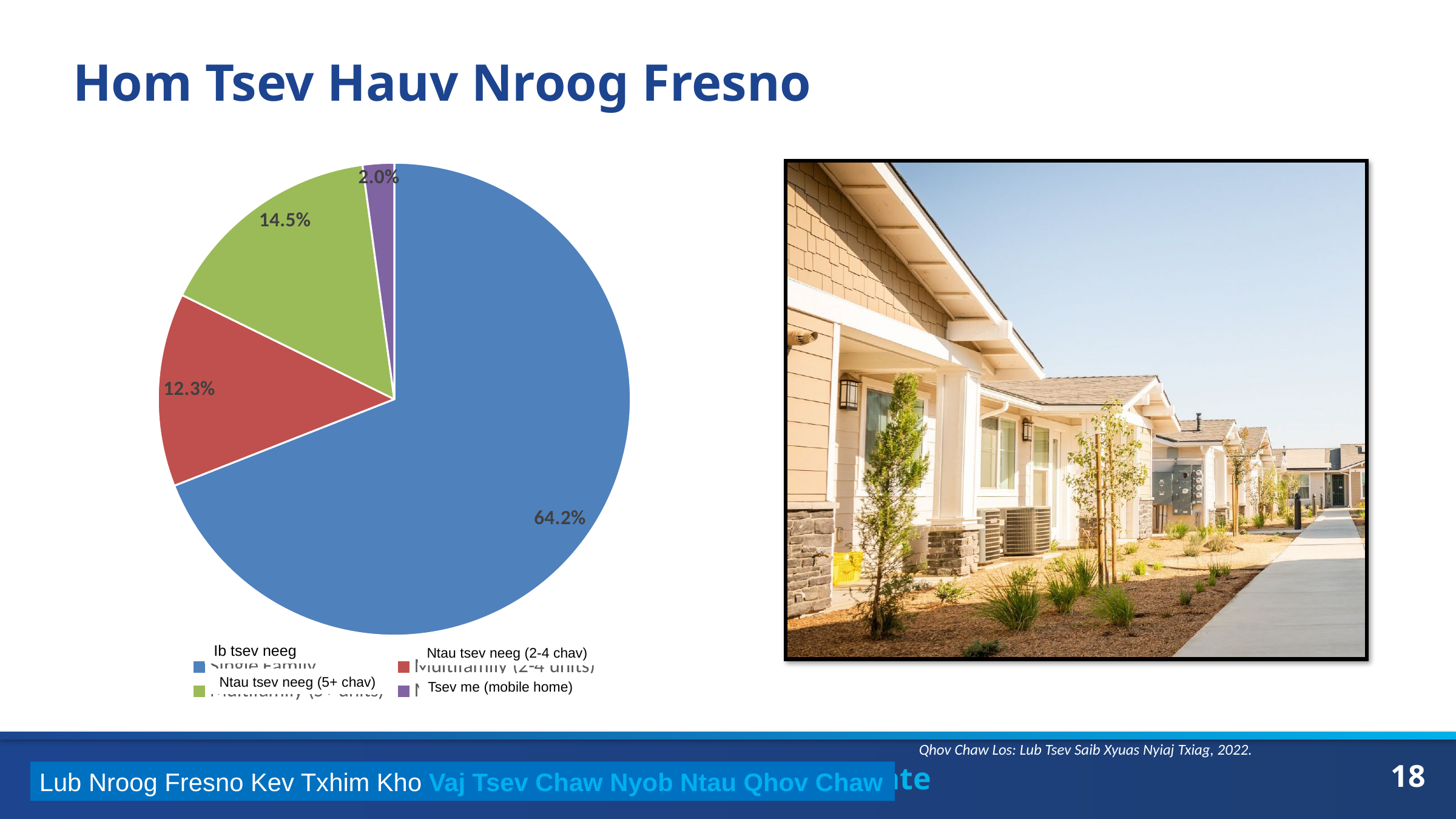
Which category has the largest slice of the pie? Ib tsev neeg What is the value shown for "Ntau tsev neeg (2-4 chav)"? 12.3% What is the difference between the "Ib tsev neeg" slice and the "Tsev me (mobile home)" slice? 62.2% Which category has the smallest slice of the pie? Tsev me (mobile home) Which is larger, the slice for "Ntau tsev neeg (5+ chav)" or the slice for "Ntau tsev neeg (2-4 chav)"? Ntau tsev neeg (5+ chav) How many slices does the pie chart have? 4 What colour is the "Ib tsev neeg" slice in the pie chart? Blue What kind of chart is shown on the slide? Pie chart What share of the pie does the "Ib tsev neeg" slice represent? 64.2% What is the difference between the "Ntau tsev neeg (5+ chav)" slice and the "Ntau tsev neeg (2-4 chav)" slice? 2.2% What is the value shown for "Ntau tsev neeg (5+ chav)"? 14.5% What is the value shown for "Tsev me (mobile home)"? 2.0%